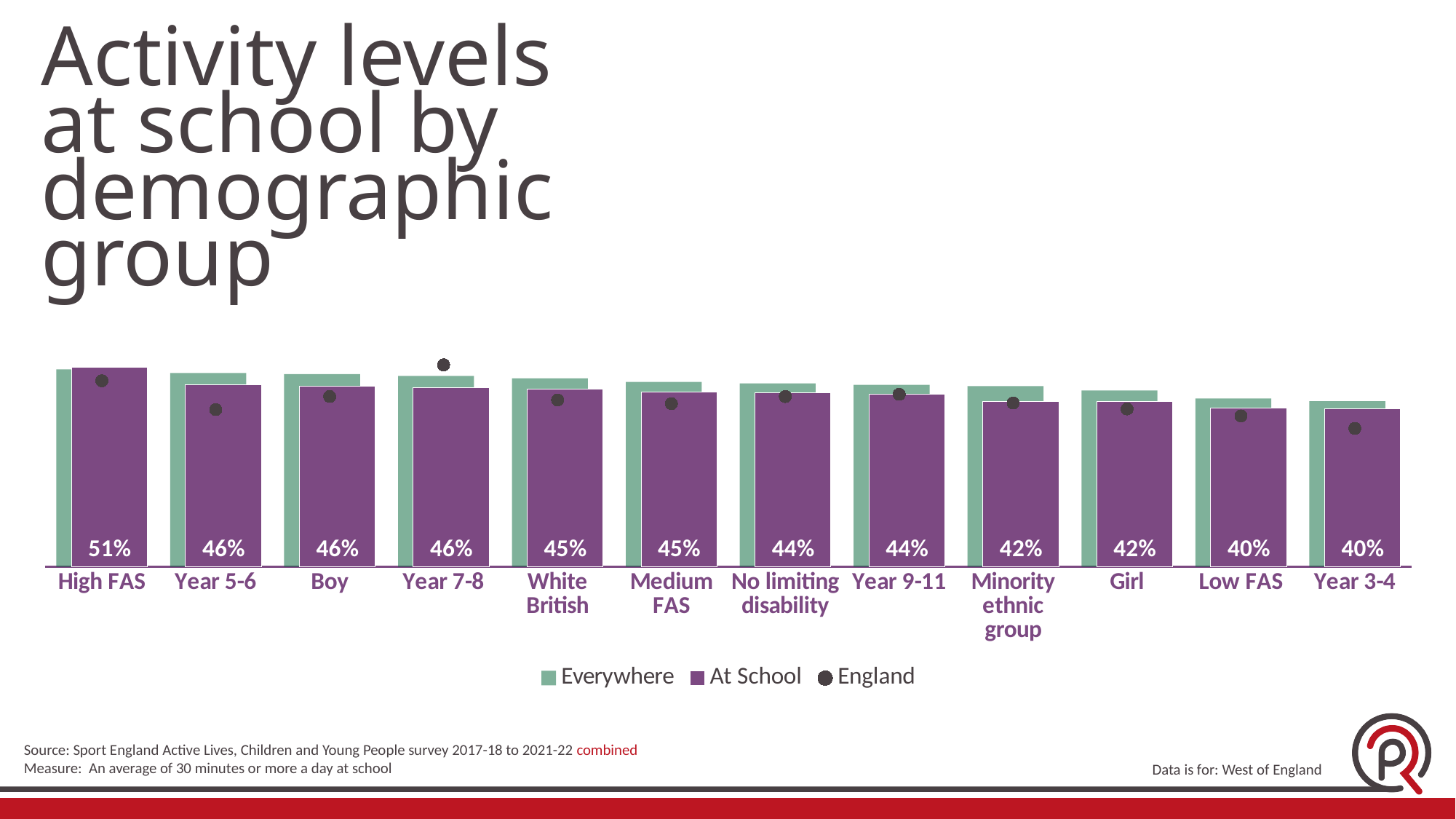
How many series does the legend list? 3 What is the At School value for No limiting disability? 44% How many demographic groups are shown on the x axis? 12 Which has the larger At School value, Boy or Girl? Boy What is the At School value for Girl? 42% What is the At School value for High FAS? 51% Do the At School values rise or fall from left to right along the x axis? Fall What is the lowest At School value shown on the chart? 40% What is the At School value for Year 3-4? 40% Which demographic group has the highest At School value? High FAS What is the difference between the At School values for High FAS and Low FAS? 11 percentage points What kind of chart is shown on the slide? Bar chart